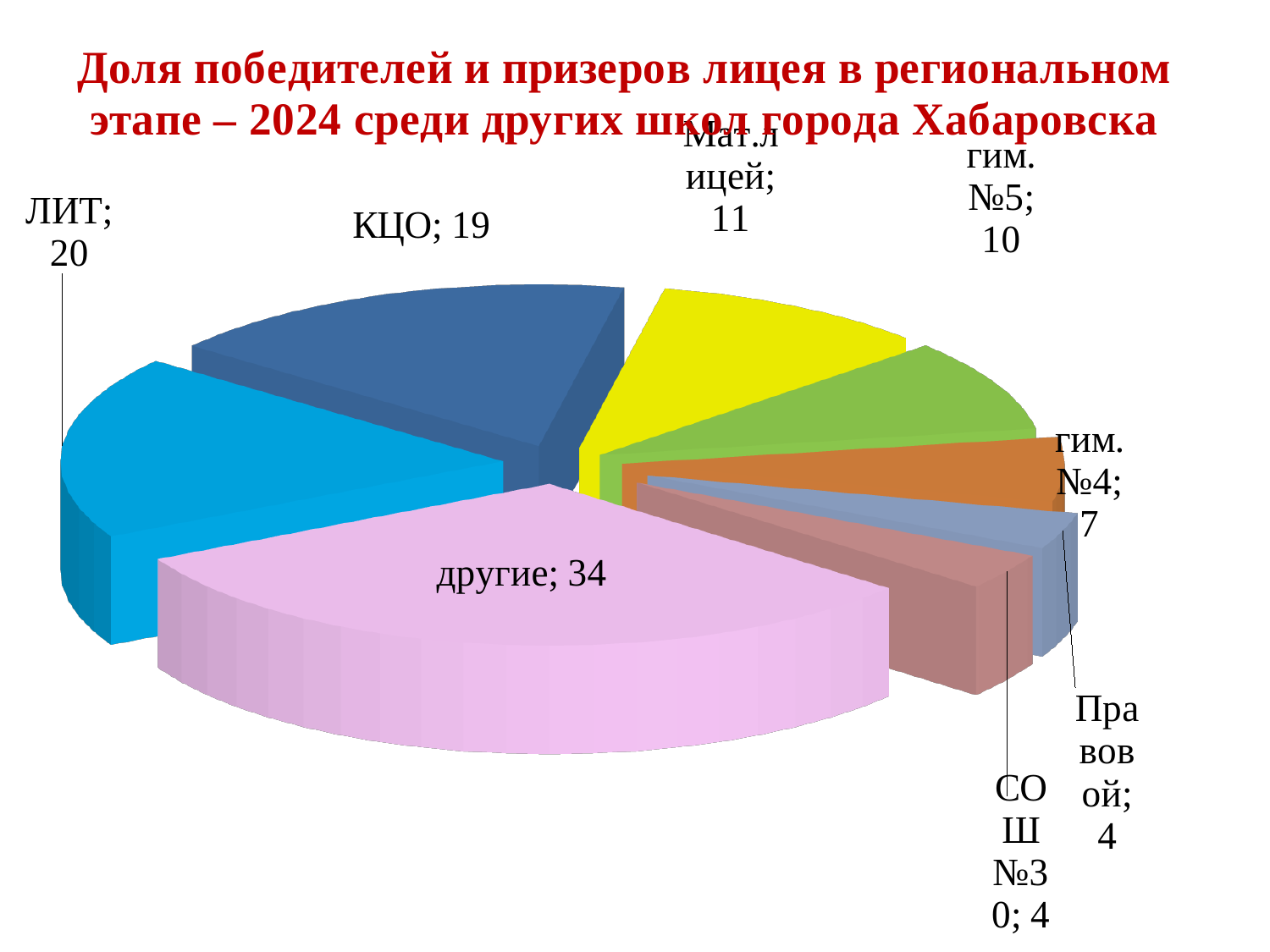
What is the value for ЛИТ? 20 What is the value for гим. №4? 7 What is the value for КЦО? 19 What is the sum of all the values shown in the pie chart? 109 What is the difference between the values for другие and ЛИТ? 14 How many slices does the pie chart have? 8 What kind of chart is shown on the slide? pie chart Which is larger, the value for ЛИТ or the value for КЦО? ЛИТ Which category has the largest slice of the pie? другие What is the value for гим. №5? 10 What is the difference between the values for гим. №5 and гим. №4? 3 What is the value for Мат.лицей? 11